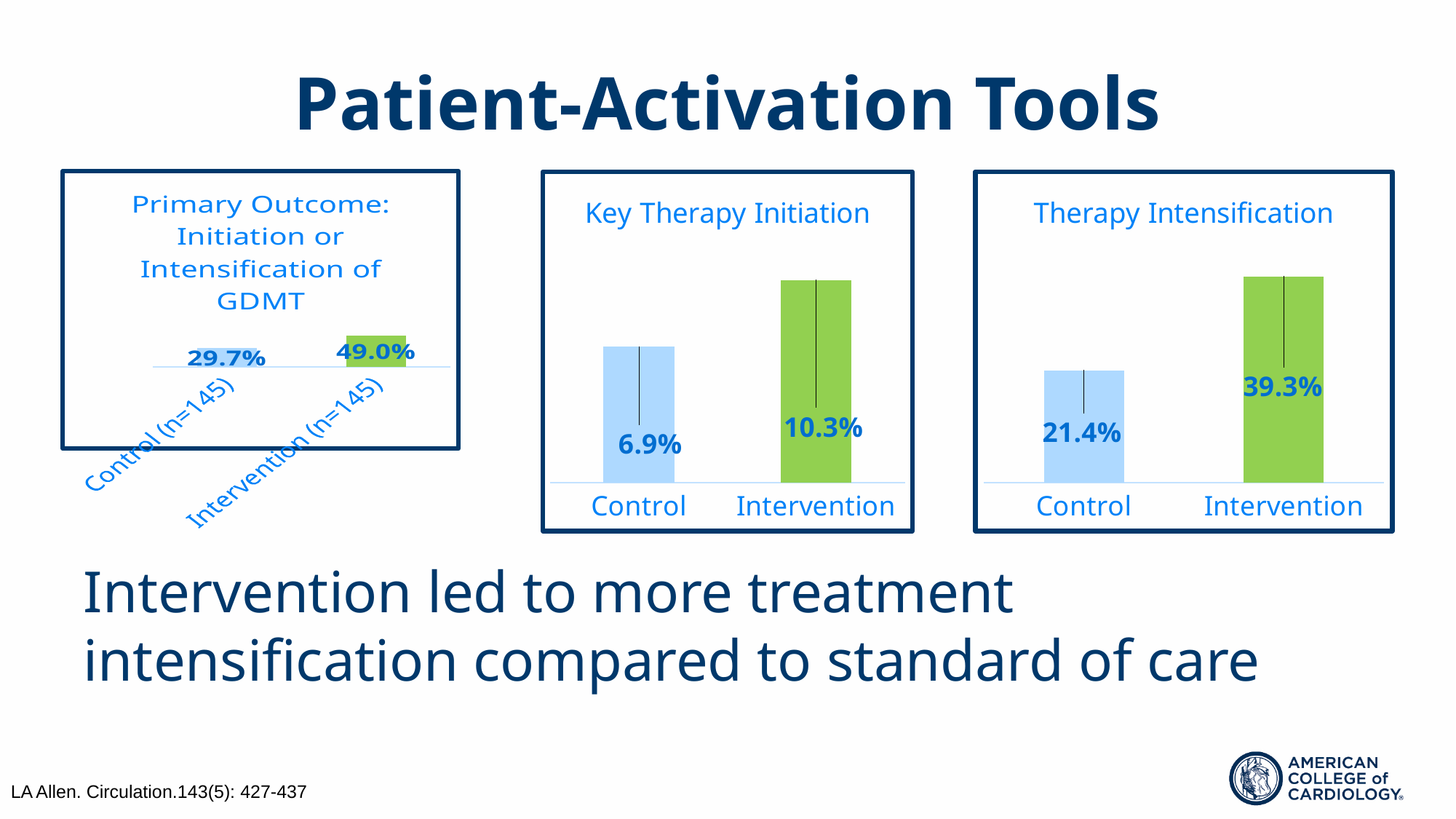
In the 'Key Therapy Initiation' chart, which category has the lowest value? Control In the 'Key Therapy Initiation' chart, what is the value for Intervention? 10.3% In the 'Therapy Intensification' chart, what is the value for Intervention? 39.3% In the 'Primary Outcome: Initiation or Intensification of GDMT' chart, what is the value for Intervention (n=145)? 49.0% In the 'Key Therapy Initiation' chart, how many categories are plotted? 2 In the 'Therapy Intensification' chart, which category has the highest value? Intervention In the 'Therapy Intensification' chart, what is the difference between the Intervention and Control values? 17.9% In the 'Primary Outcome: Initiation or Intensification of GDMT' chart, what is the value for Control (n=145)? 29.7% In the 'Key Therapy Initiation' chart, what is the value for Control? 6.9% In the 'Primary Outcome: Initiation or Intensification of GDMT' chart, what is the difference between the Intervention and Control values? 19.3% What kind of chart is the 'Therapy Intensification' chart? Bar chart In the 'Therapy Intensification' chart, what is the value for Control? 21.4%